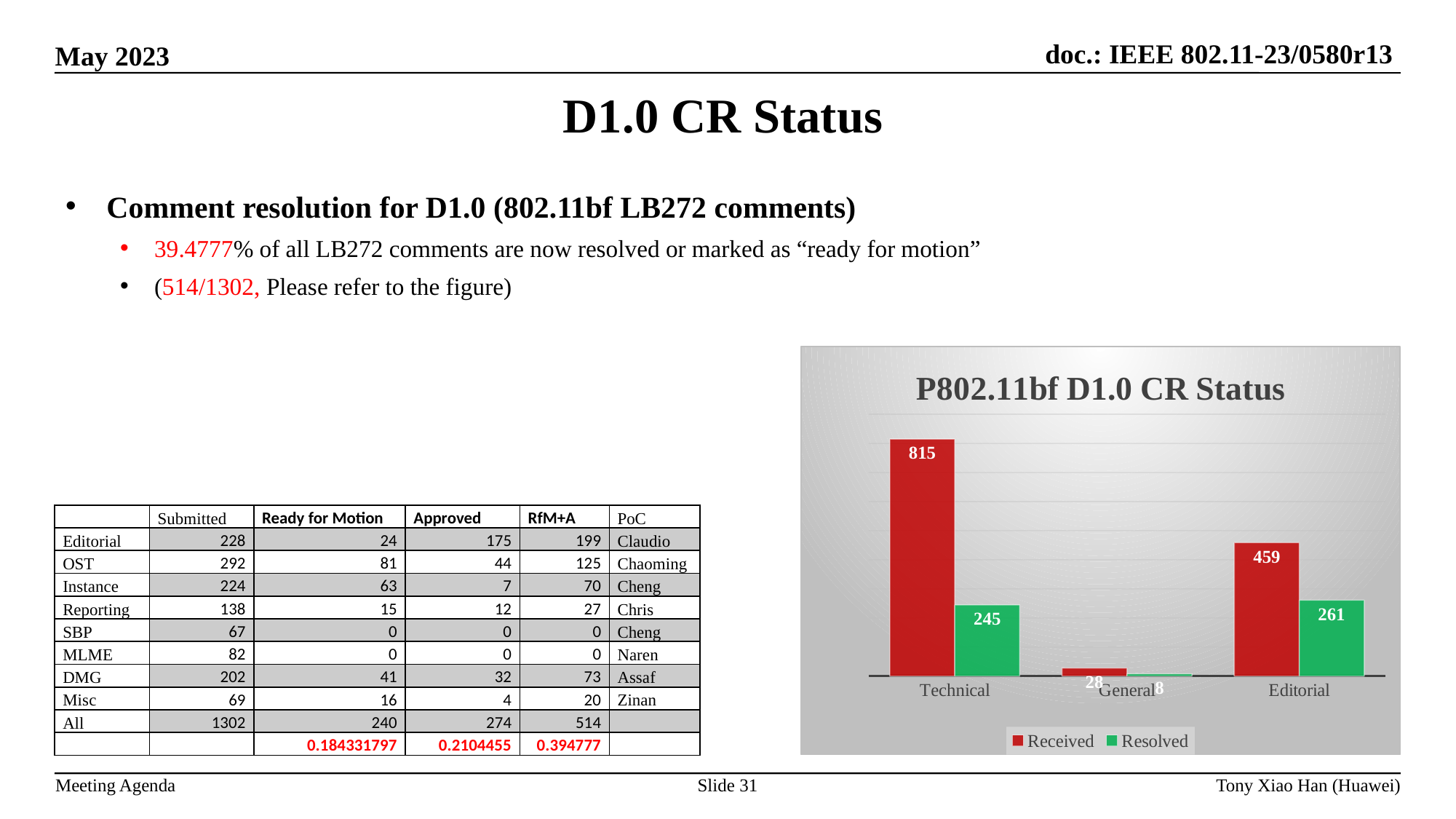
What is the title of the chart on the slide? P802.11bf D1.0 CR Status What kind of chart is shown on the slide? bar chart What is the Resolved value for Editorial in the chart? 261 What is the Received value for General in the chart? 28 What is the Received value for Technical in the chart? 815 How many categories are shown on the x axis of the chart? 3 Which colour represents the Resolved series in the chart? green What is the difference between the Received and Resolved values for Technical? 570 Which is larger in the chart: the Resolved value for Technical or the Resolved value for Editorial? Editorial How many series does the chart legend list? 2 Which category has the lowest Resolved value in the chart? General Which category has the highest Received value in the chart? Technical